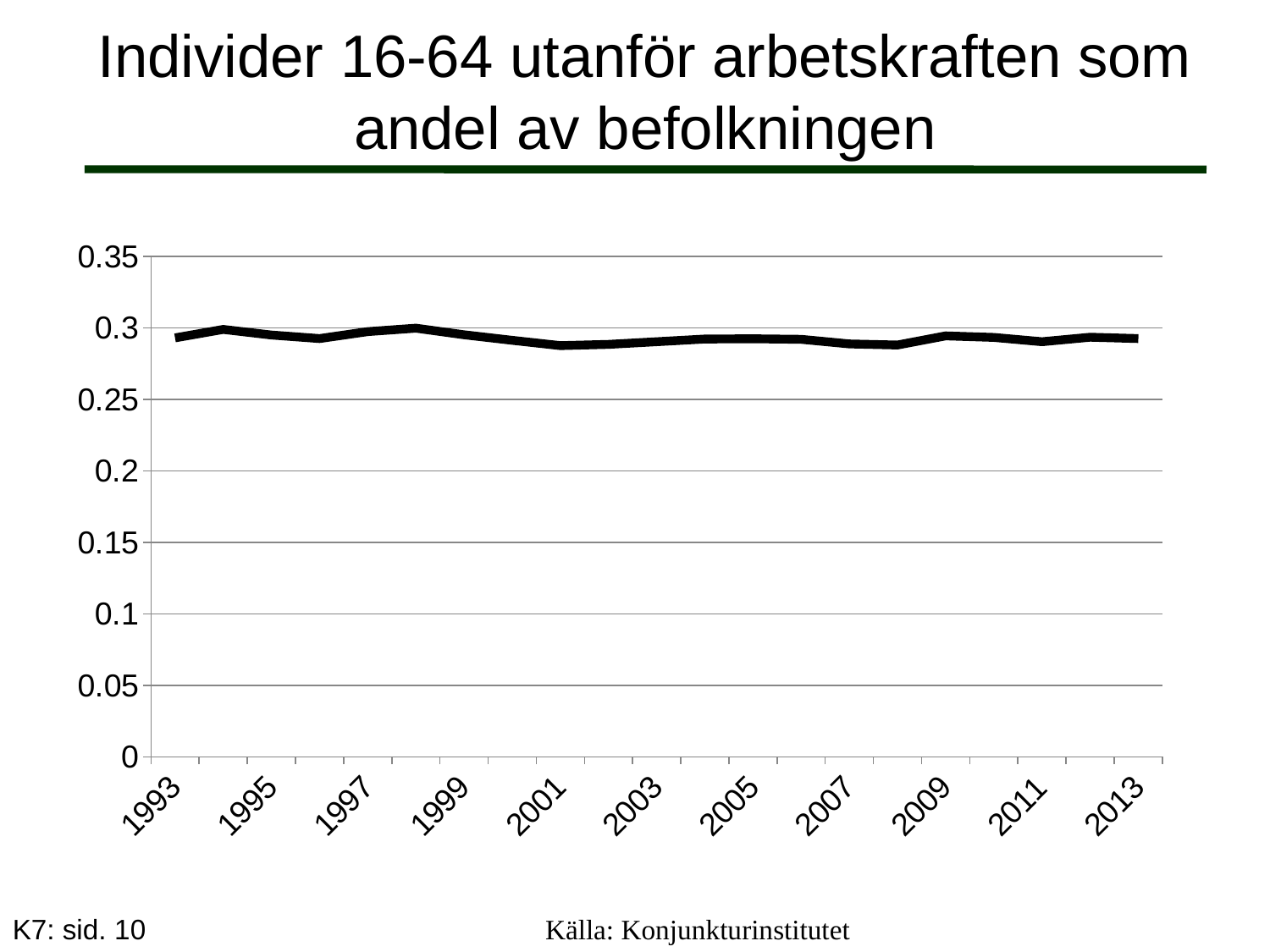
What is the highest value shown on the y axis? 0.35 What kind of chart is shown on the slide? line chart Is the value for 2001 greater or less than 0.2? greater What is the first year shown on the x axis? 1993 Is the value for 1999 greater or less than 0.25? greater Is the value for 1993 greater or less than 0.25? greater What source is cited below the chart? Konjunkturinstitutet What is the last year shown on the x axis? 2013 Does the line show a strong upward trend, a strong downward trend, or stay roughly flat from 1993 to 2013? roughly flat What is the title of the chart? Individer 16-64 utanför arbetskraften som andel av befolkningen